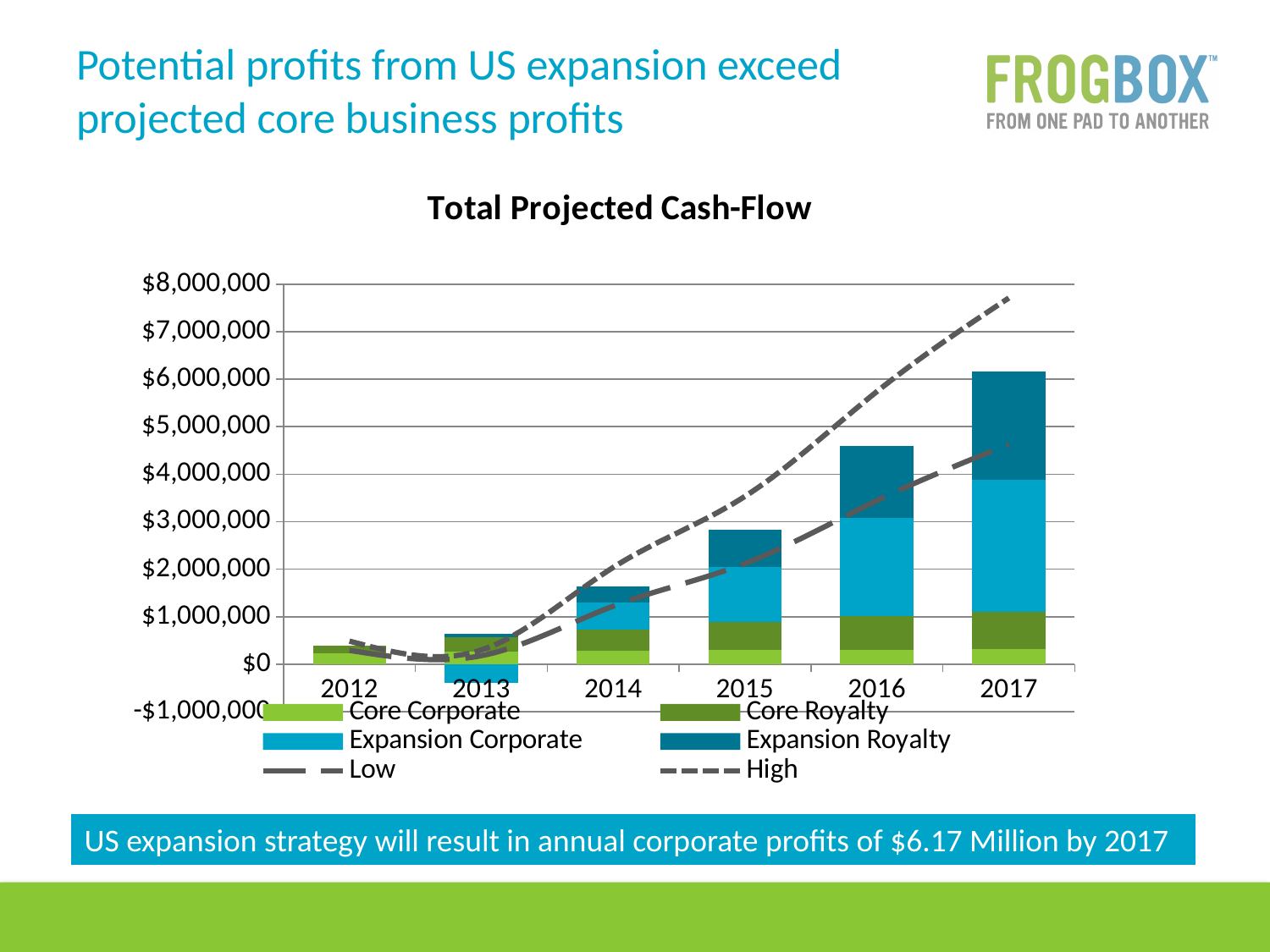
Is the total stacked bar for 2016 greater or less than $4,000,000? greater Do the stacked bar totals rise or fall from 2014 to 2017? rise Which year has the larger total stacked bar, 2016 or 2017? 2017 Is the total stacked bar for 2017 greater or less than $5,000,000? greater What is the title of the chart? Total Projected Cash-Flow How many series does the chart legend list? 6 Is the Low line value for 2017 greater or less than $5,000,000? less Which year has the tallest stacked bar in the chart? 2017 How many years are shown on the x axis of the chart? 6 What kind of chart is shown on the slide? Stacked bar chart with line series